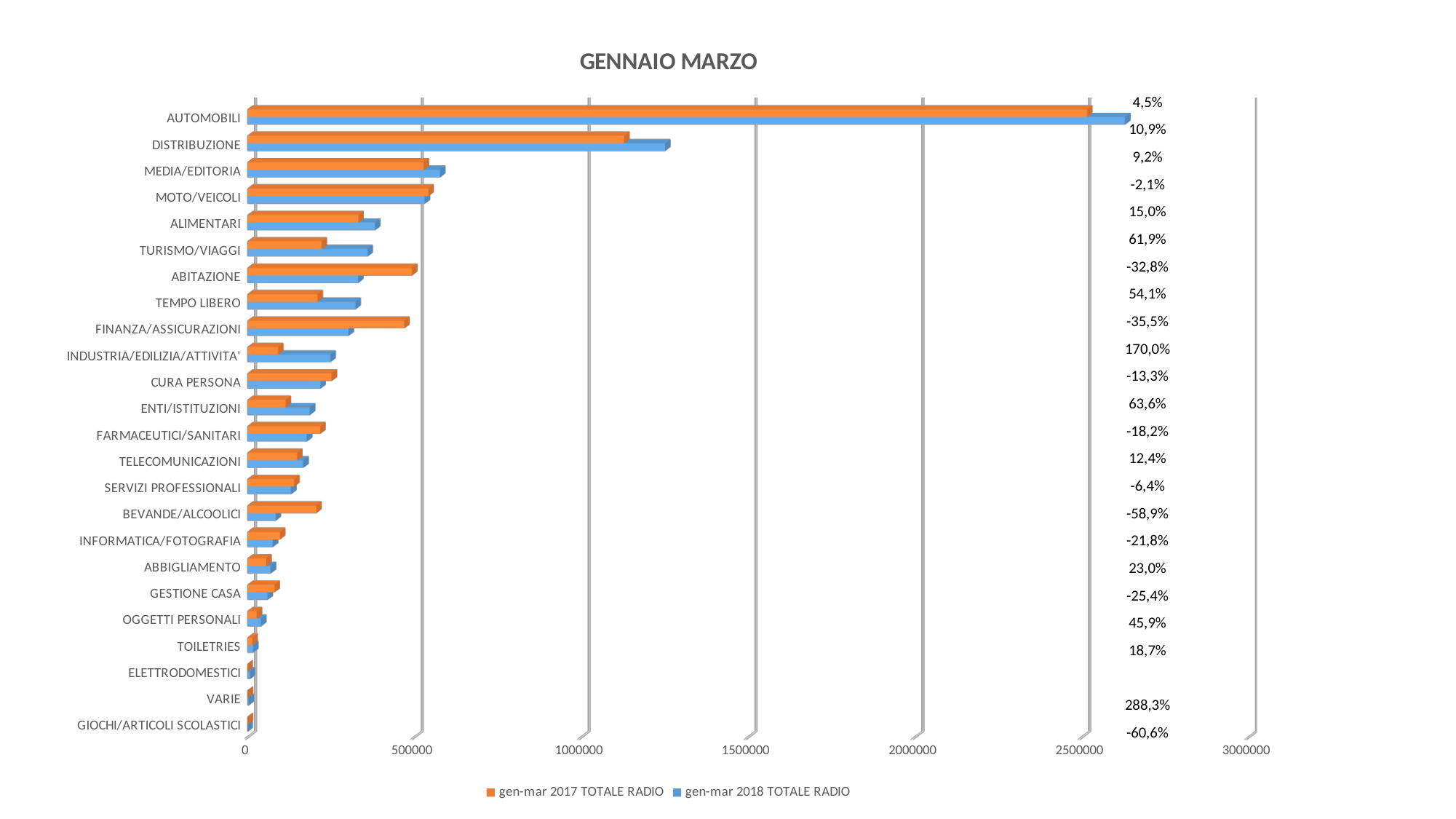
How many categories are plotted on the chart? 24 For ABITAZIONE, which series has the larger value: gen-mar 2017 TOTALE RADIO or gen-mar 2018 TOTALE RADIO? gen-mar 2017 TOTALE RADIO Is the gen-mar 2018 TOTALE RADIO value for DISTRIBUZIONE greater or less than 1000000? greater For TURISMO/VIAGGI, which series has the larger value: gen-mar 2017 TOTALE RADIO or gen-mar 2018 TOTALE RADIO? gen-mar 2018 TOTALE RADIO What type of chart is shown on the slide? bar chart Which category has the highest value for gen-mar 2018 TOTALE RADIO? AUTOMOBILI Is the gen-mar 2018 TOTALE RADIO value for AUTOMOBILI greater or less than 2500000? greater Which series is shown in orange in the legend? gen-mar 2017 TOTALE RADIO Which category has the highest value for gen-mar 2017 TOTALE RADIO? AUTOMOBILI How many series does the legend list? 2 Is the gen-mar 2017 TOTALE RADIO value for ALIMENTARI greater or less than 500000? less What is the title of the chart? GENNAIO MARZO